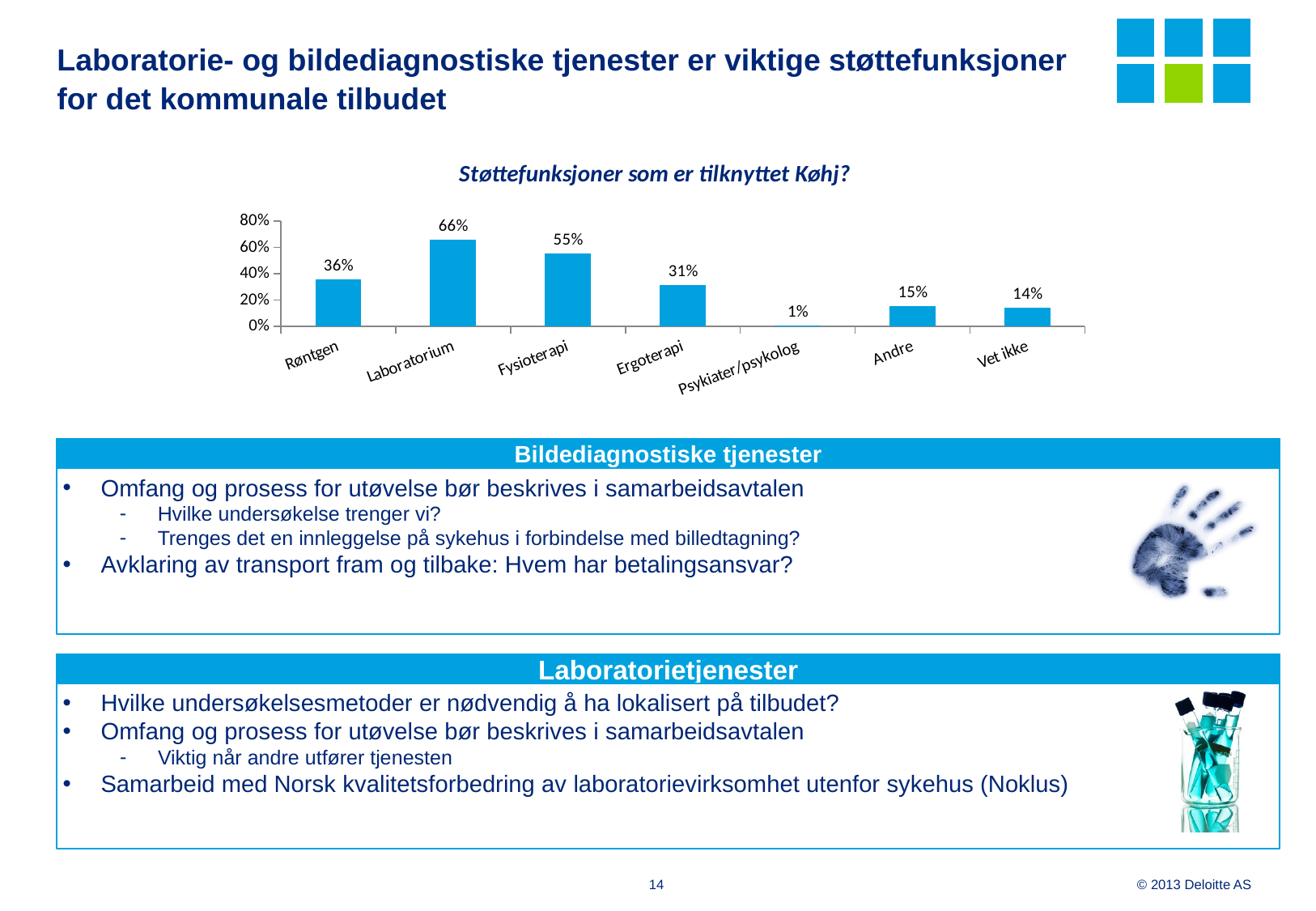
Which is larger, the value for Røntgen or the value for Ergoterapi? Røntgen Which category has the highest value? Laboratorium Is the value for Fysioterapi greater or less than 40%? greater What kind of chart is shown on the slide? bar chart What is the title of the chart? Støttefunksjoner som er tilknyttet Køhj? What is the difference between the values for Laboratorium and Fysioterapi? 11% What is the value for Psykiater/psykolog? 1% How many categories are shown on the x axis? 7 What is the value for Laboratorium? 66% What is the difference between the values for Andre and Vet ikke? 1% What is the value for Ergoterapi? 31% Which category has the lowest value? Psykiater/psykolog